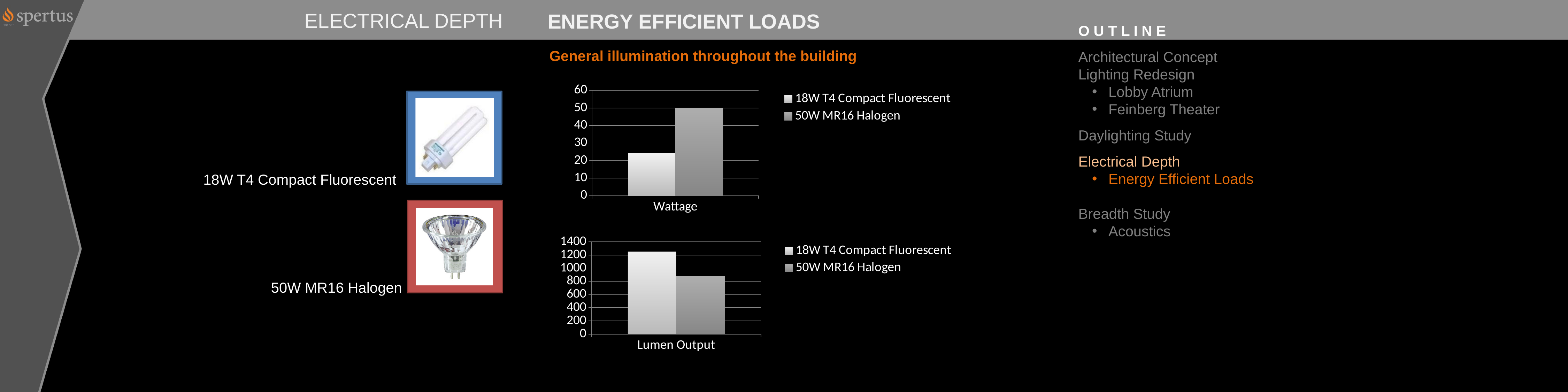
In the Wattage chart, which series has the higher value? 50W MR16 Halogen In the Wattage chart, which series has the lower value? 18W T4 Compact Fluorescent In the Lumen Output chart, is the value for 50W MR16 Halogen larger or smaller than the value for 18W T4 Compact Fluorescent? smaller In the Lumen Output chart, which series has the higher value? 18W T4 Compact Fluorescent What kind of chart is the Wattage chart? bar chart What is the highest value shown on the vertical axis of the Lumen Output chart? 1400 In the Lumen Output chart, is the value for 18W T4 Compact Fluorescent greater or less than 1000? greater What is the category label on the x axis of the lower chart? Lumen Output In the Wattage chart, is the value for 50W MR16 Halogen greater or less than 40? greater In the Wattage chart, is the value for 18W T4 Compact Fluorescent greater or less than 30? less How many series does the legend of the Wattage chart list? 2